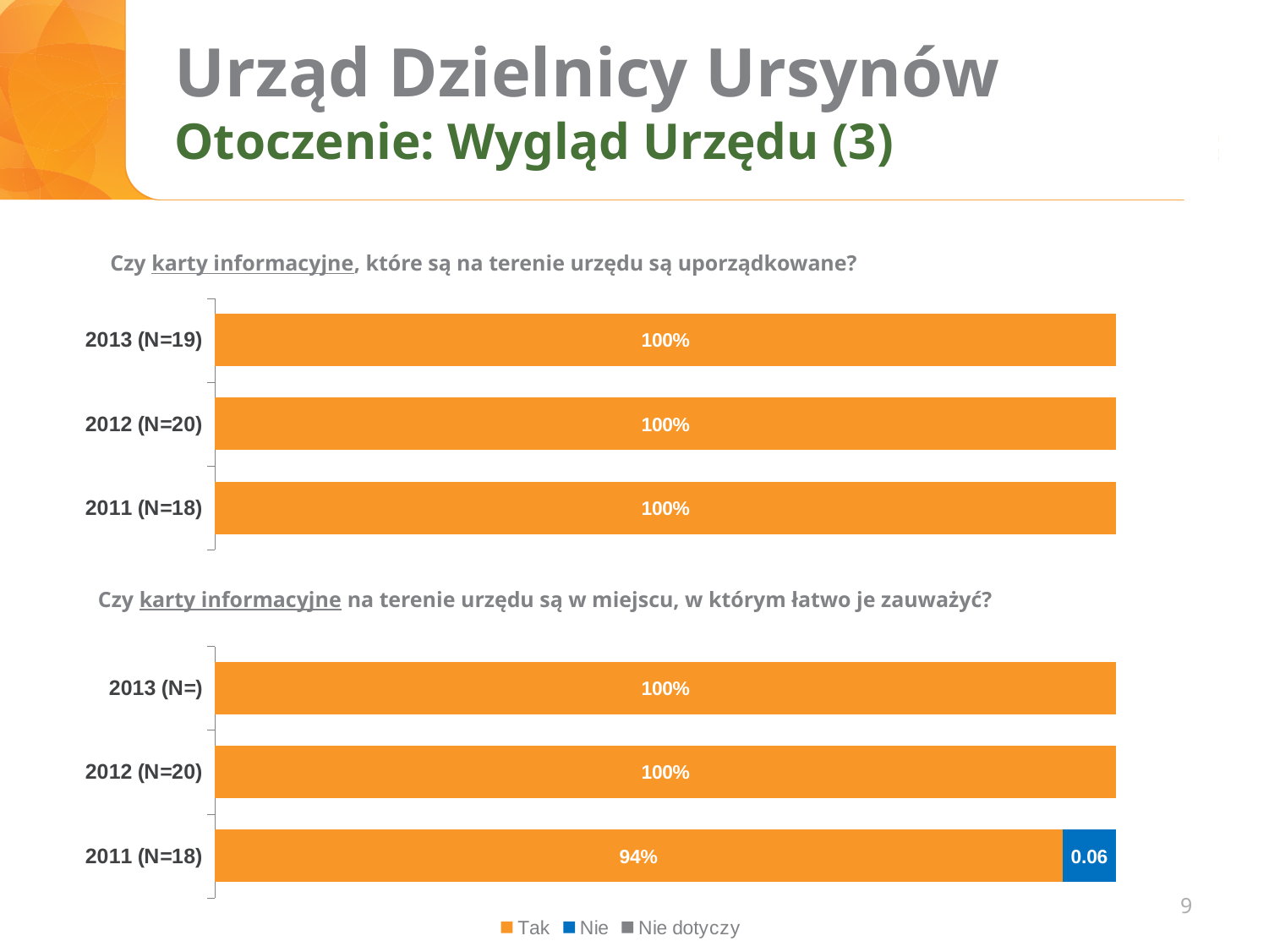
In the top chart ("Czy karty informacyjne, które są na terenie urzędu są uporządkowane?"), what is the value for Tak in 2013 (N=19)? 100% In the top chart ("Czy karty informacyjne, które są na terenie urzędu są uporządkowane?"), what is the value for Tak in 2011 (N=18)? 100% In the bottom chart ("Czy karty informacyjne na terenie urzędu są w miejscu, w którym łatwo je zauważyć?"), what is the value for Tak in 2012 (N=20)? 100% In the bottom chart ("Czy karty informacyjne na terenie urzędu są w miejscu, w którym łatwo je zauważyć?"), what is the value for Tak in 2011 (N=18)? 94% In the bottom chart ("Czy karty informacyjne na terenie urzędu są w miejscu, w którym łatwo je zauważyć?"), what is the difference between the Tak value for 2012 (N=20) and the Tak value for 2011 (N=18)? 6% How many series does the legend at the bottom of the slide list? 3 In the bottom chart ("Czy karty informacyjne na terenie urzędu są w miejscu, w którym łatwo je zauważyć?"), is the Tak value for 2013 larger or smaller than the Tak value for 2011 (N=18)? larger In the bottom chart ("Czy karty informacyjne na terenie urzędu są w miejscu, w którym łatwo je zauważyć?"), what is the value for Nie in 2011 (N=18)? 0.06 What colour represents the Tak series in the charts? orange In the top chart ("Czy karty informacyjne, które są na terenie urzędu są uporządkowane?"), how many year categories are shown? 3 What type of chart is used for the two charts on the slide? bar chart In the bottom chart ("Czy karty informacyjne na terenie urzędu są w miejscu, w którym łatwo je zauważyć?"), which year has the lowest Tak value? 2011 (N=18)